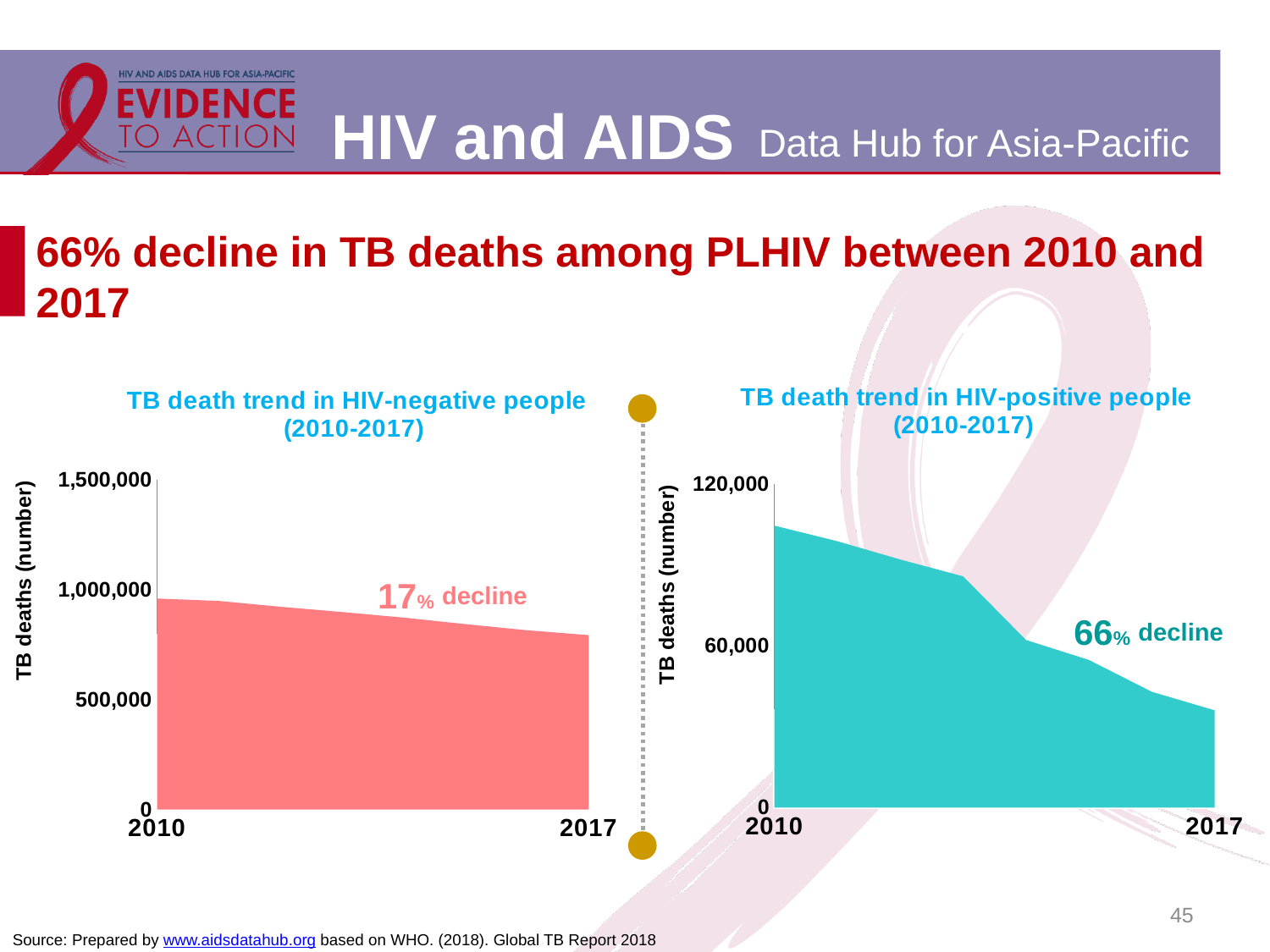
In the 'TB death trend in HIV-positive people (2010-2017)' chart, which year has the higher value, 2010 or 2017? 2010 In the 'TB death trend in HIV-positive people (2010-2017)' chart, do TB deaths rise or fall from 2010 to 2017? fall In the 'TB death trend in HIV-positive people (2010-2017)' chart, is the value for 2010 greater or less than 60,000? greater What percentage decline is annotated on the 'TB death trend in HIV-positive people (2010-2017)' chart? 66% decline What kind of chart is the 'TB death trend in HIV-negative people (2010-2017)' chart? area chart What is the y-axis label on the 'TB death trend in HIV-positive people (2010-2017)' chart? TB deaths (number) What percentage decline is annotated on the 'TB death trend in HIV-negative people (2010-2017)' chart? 17% decline What colour is the shaded area in the 'TB death trend in HIV-negative people (2010-2017)' chart? pink/red In the 'TB death trend in HIV-positive people (2010-2017)' chart, is the value for 2017 greater or less than 60,000? less In the 'TB death trend in HIV-negative people (2010-2017)' chart, is the value for 2017 greater or less than 1,000,000? less In the 'TB death trend in HIV-negative people (2010-2017)' chart, do TB deaths rise or fall from 2010 to 2017? fall